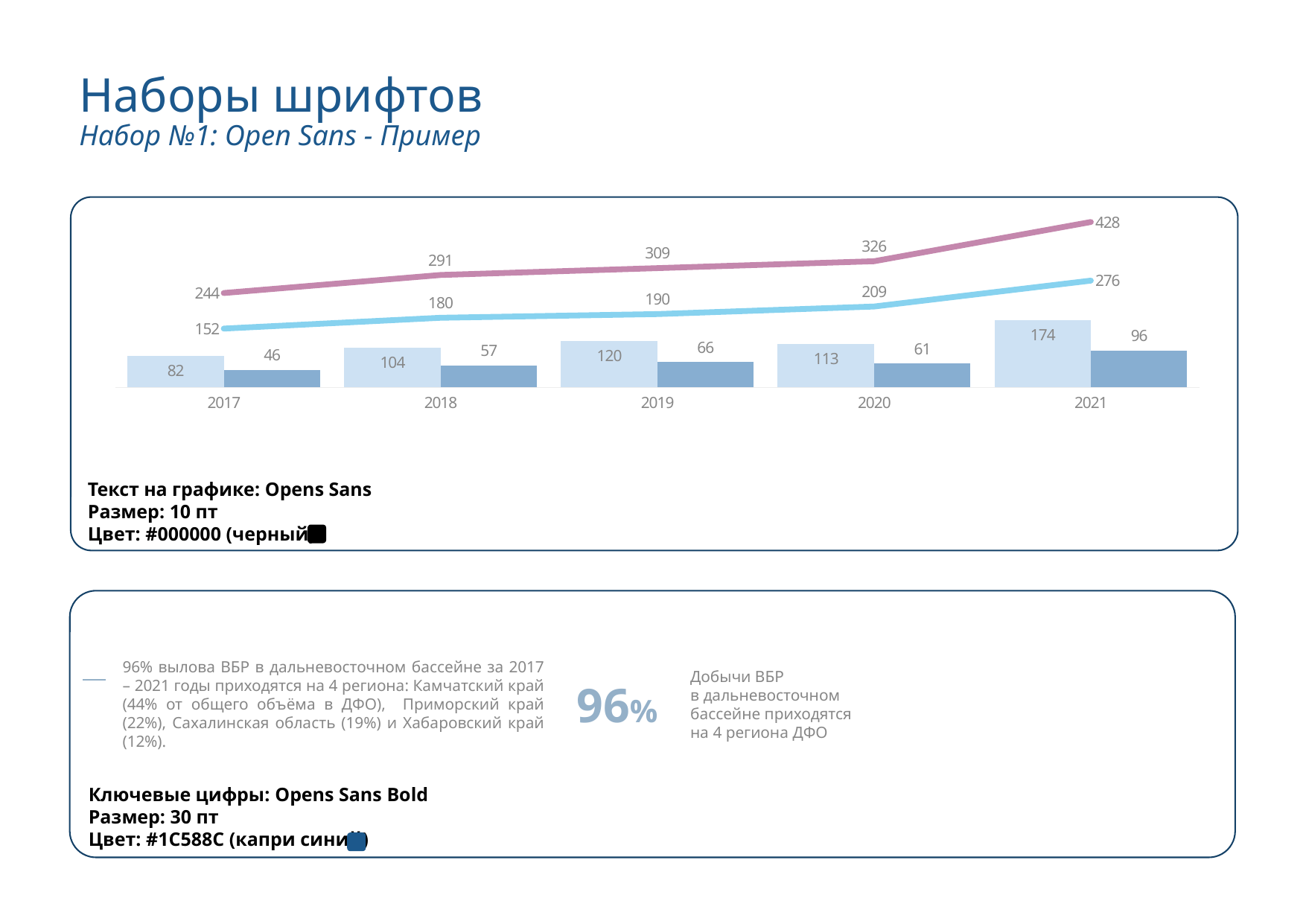
Does the light blue (cyan) line rise or fall from 2017 to 2021? Rises What kind of chart is shown on the slide? Combined bar and line chart What is the value of the pink line for 2021? 428 What is the difference between the light blue bar values for 2021 and 2017? 92 In which year does the pink line reach its highest value? 2021 How many years are shown on the x axis of the chart? 5 What is the value of the light blue (cyan) line for 2020? 209 What is the difference between the pink line values for 2021 and 2020? 102 In which year is the dark blue bar the lowest? 2017 What is the value of the light blue bar for 2019? 120 Which is larger: the light blue bar for 2019 or the light blue bar for 2020? 2019 What is the value of the dark blue bar for 2018? 57